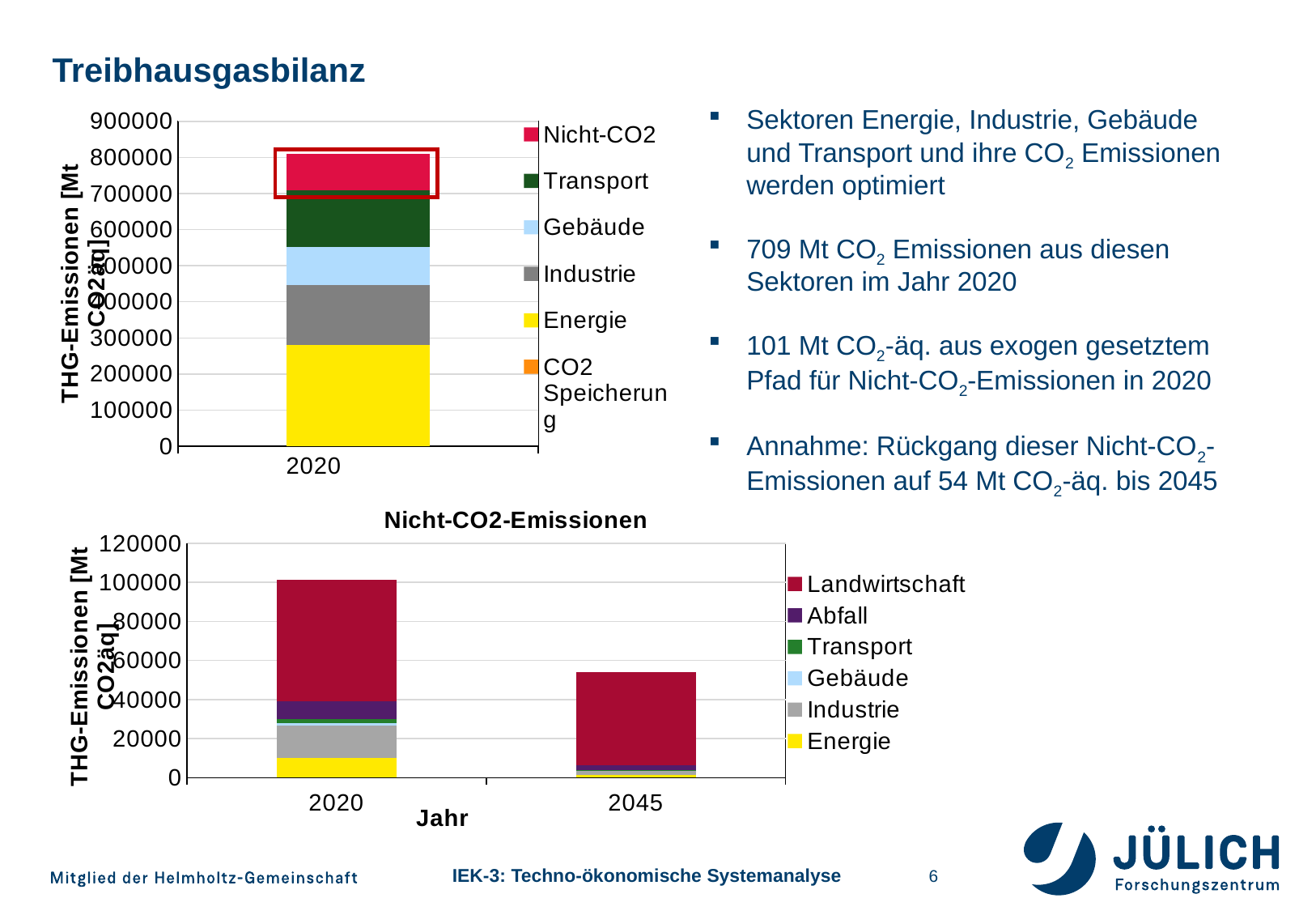
How many series does the legend of the top chart list? 6 What kind of chart is the chart titled "Nicht-CO2-Emissionen"? stacked bar chart In the chart titled "Nicht-CO2-Emissionen", which series forms the largest segment of the 2045 bar? Landwirtschaft In the chart titled "Nicht-CO2-Emissionen", do the total emissions rise or fall from 2020 to 2045? fall What kind of chart is the top chart on the slide? stacked bar chart In the chart titled "Nicht-CO2-Emissionen", is the total for 2020 greater or less than 80000? greater In the chart titled "Nicht-CO2-Emissionen", is the total for 2045 greater or less than 60000? less What is the x-axis title of the chart titled "Nicht-CO2-Emissionen"? Jahr In the top chart, is the Energie segment for 2020 greater or less than 300000? less How many categories are shown on the x axis of the top chart? 1 How many years are shown on the x axis of the chart titled "Nicht-CO2-Emissionen"? 2 How many series does the legend of the chart titled "Nicht-CO2-Emissionen" list? 6